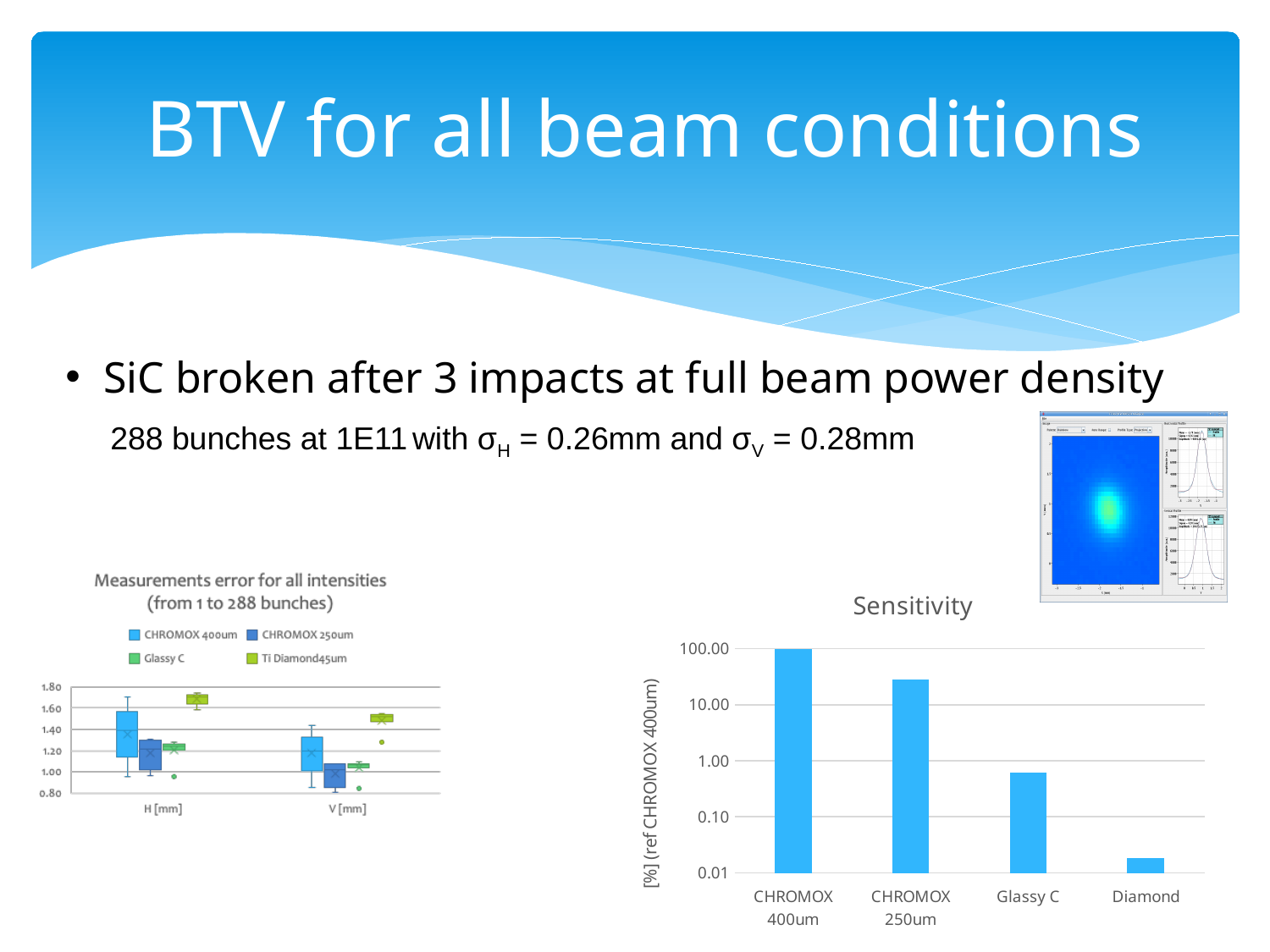
What is the y-axis label of the 'Sensitivity' chart? [%] (ref CHROMOX 400um) In the 'Sensitivity' chart, is the value for CHROMOX 250um greater or less than 10.00? greater How many series does the legend of the 'Measurements error for all intensities' chart list? 4 How many categories are shown on the x axis of the 'Sensitivity' chart? 4 In the 'Sensitivity' chart, is the value for Glassy C greater or less than 1.00? less In the 'Sensitivity' chart, which category has the highest value? CHROMOX 400um What kind of chart is the 'Sensitivity' chart? bar chart In the 'Measurements error for all intensities' chart, which series has the highest value for H [mm]? Ti Diamond45um In the 'Sensitivity' chart, what is the value for CHROMOX 400um? 100.00 In the 'Sensitivity' chart, which category has the lowest value? Diamond In the 'Sensitivity' chart, is the value for Diamond greater or less than 0.10? less In the 'Sensitivity' chart, which is larger, the value for CHROMOX 250um or the value for Glassy C? CHROMOX 250um